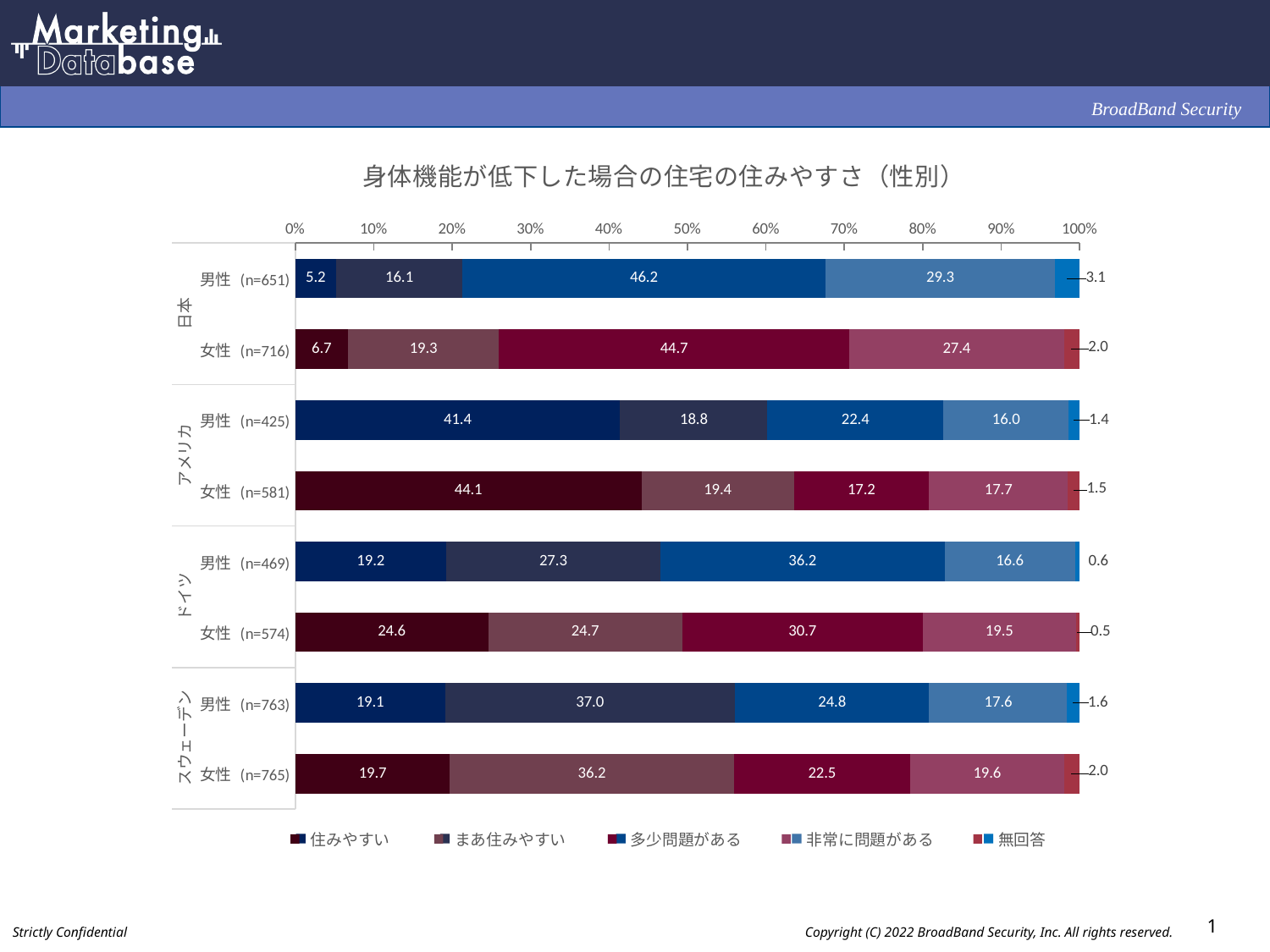
What is the difference between the 多少問題がある values for 日本 男性 (n=651) and 日本 女性 (n=716)? 1.5 Which category has the highest value for 住みやすい? アメリカ 女性 (n=581) How many series does the legend list? 5 What type of chart is shown on the slide? Stacked bar chart What is the value of 多少問題がある for 日本 男性 (n=651)? 46.2 What is the value of 無回答 for ドイツ 女性 (n=574)? 0.5 How many bars (categories) are plotted in the chart? 8 What is the value of まあ住みやすい for スウェーデン 男性 (n=763)? 37.0 What is the value of 住みやすい for アメリカ 女性 (n=581)? 44.1 What is the title of the chart? 身体機能が低下した場合の住宅の住みやすさ（性別） Which is larger: the 非常に問題がある value for ドイツ 男性 (n=469) or for ドイツ 女性 (n=574)? ドイツ 女性 (n=574) Which category has the lowest value for 住みやすい? 日本 男性 (n=651)